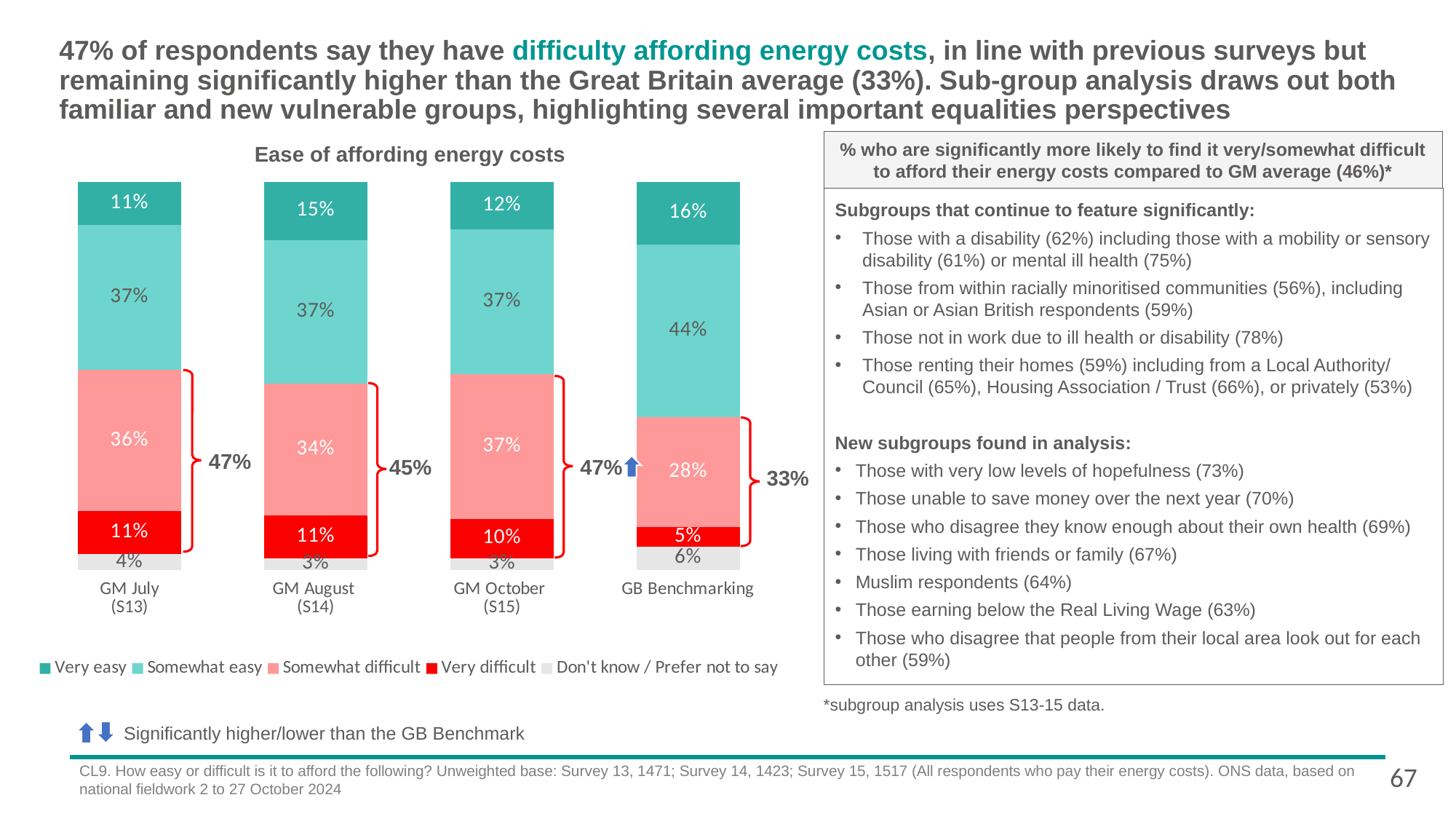
What is the 'Somewhat easy' value for GB Benchmarking? 44% What is the 'Very easy' value for GM August (S14)? 15% What is the combined 'Somewhat difficult' plus 'Very difficult' total shown by the bracket for GM August (S14)? 45% How many series does the chart's legend list? 5 Which category has the highest 'Somewhat difficult' value? GM October (S15) Which is larger: the 'Very easy' value for GM July (S13) or for GB Benchmarking? GB Benchmarking What is the title of the chart on the slide? Ease of affording energy costs What is the 'Very difficult' value for GM October (S15)? 10% How many bars (categories) are shown in the chart? 4 What is the difference between the 'Somewhat difficult' values for GM July (S13) and GB Benchmarking? 8% What kind of chart is shown on the slide? Stacked bar chart Which category has the lowest 'Very difficult' value? GB Benchmarking